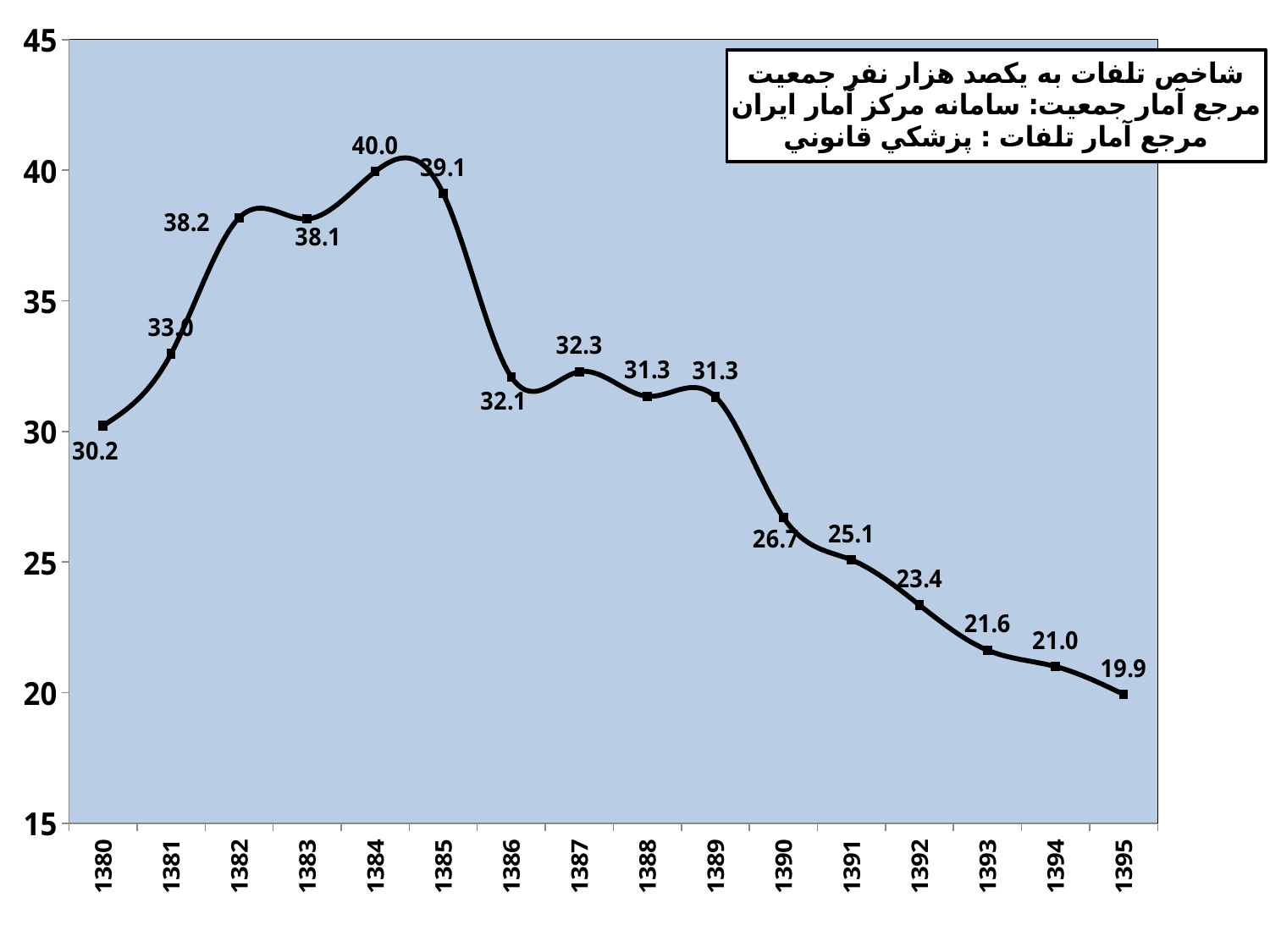
What type of chart is shown on the slide? line chart What is the value for 1380? 30.2 What is the difference between the values for 1381 and 1380? 2.8 Which year has the highest value? 1384 Which year has the lowest value? 1395 Does the value rise or fall from 1389 to 1395? fall What is the value for 1390? 26.7 What is the value for 1395? 19.9 How many years are plotted on the x axis? 16 Which is larger, the value for 1385 or the value for 1386? 1385 What is the difference between the values for 1384 and 1395? 20.1 What is the value for 1384? 40.0